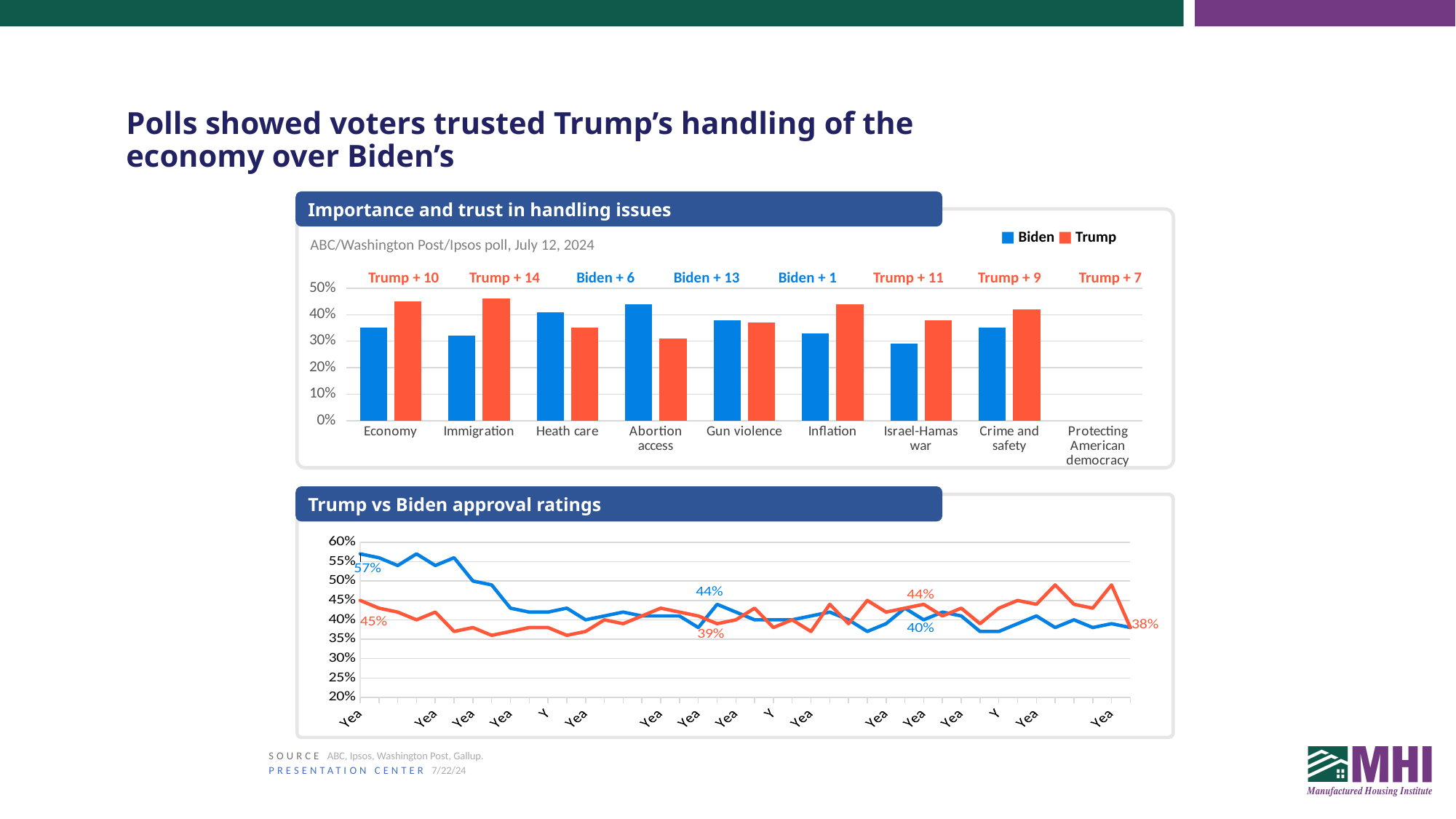
In the 'Trump vs Biden approval ratings' chart, what is the last labelled value on Biden's line? 40% In the 'Importance and trust in handling issues' chart, how many series does the legend list? 2 In the 'Importance and trust in handling issues' chart, what margin is printed above the Abortion access bars? Biden + 13 In the 'Importance and trust in handling issues' chart, which candidate has the taller bar for Abortion access? Biden In the 'Importance and trust in handling issues' chart, which candidate has the taller bar for Economy? Trump In the 'Trump vs Biden approval ratings' chart, does Biden's line generally rise or fall from left to right? fall In the 'Importance and trust in handling issues' chart, what margin is printed above the Immigration bars? Trump + 14 In the 'Importance and trust in handling issues' chart, is Trump's value for Inflation greater or less than 40%? greater In the 'Importance and trust in handling issues' chart, is Biden's value for Immigration greater or less than 40%? less What kind of chart is the 'Importance and trust in handling issues' chart? bar chart What kind of chart is the 'Trump vs Biden approval ratings' chart? line chart In the 'Trump vs Biden approval ratings' chart, what is the first labelled value on Biden's line? 57%